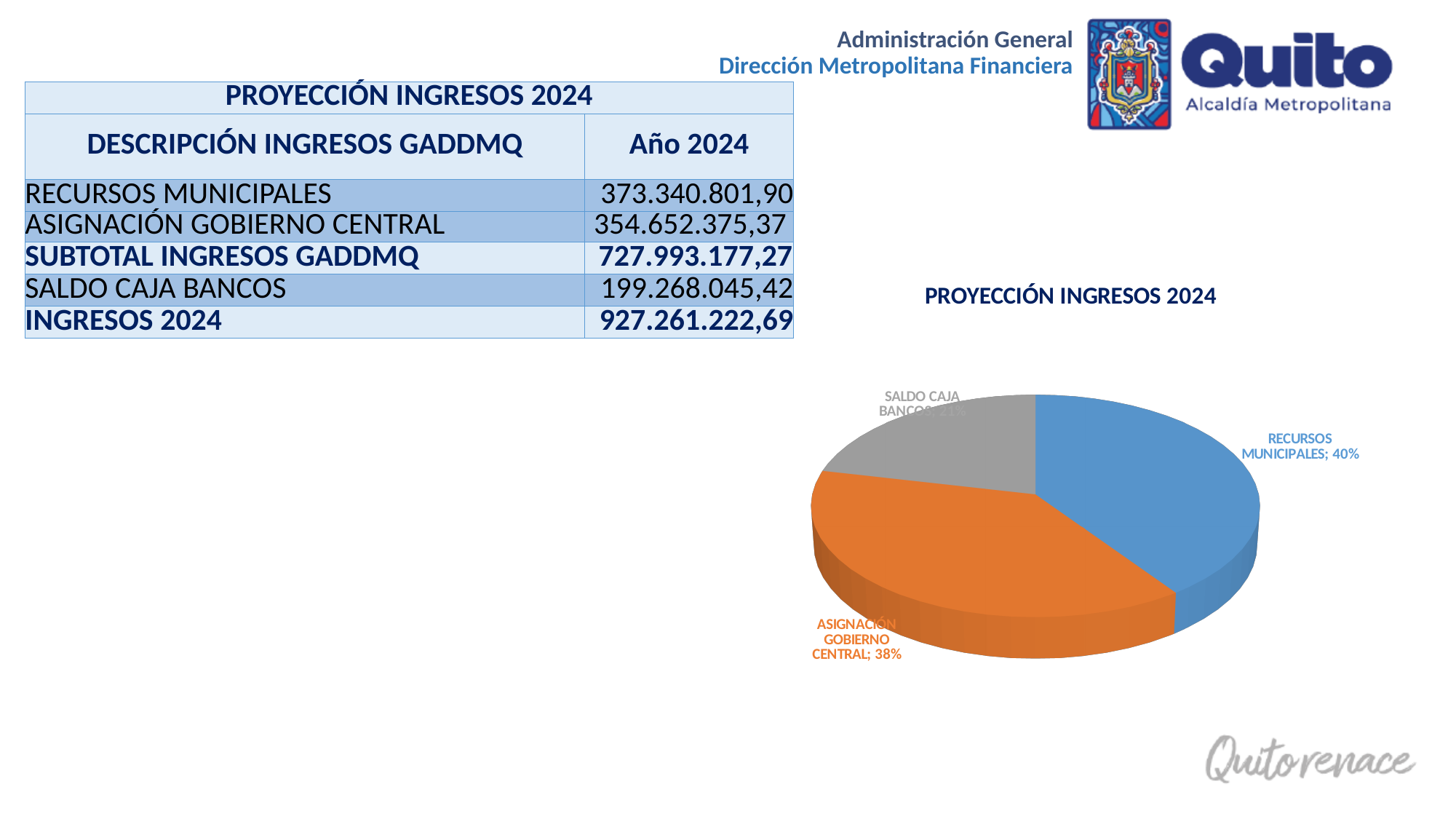
Which is larger in the pie chart, ASIGNACIÓN GOBIERNO CENTRAL or SALDO CAJA BANCOS? ASIGNACIÓN GOBIERNO CENTRAL By how many percentage points does ASIGNACIÓN GOBIERNO CENTRAL exceed SALDO CAJA BANCOS in the pie chart? 17 percentage points What is the title of the pie chart? PROYECCIÓN INGRESOS 2024 Which slice of the pie chart is the smallest? SALDO CAJA BANCOS What share of the pie does RECURSOS MUNICIPALES represent? 40% How many slices does the pie chart have? 3 What share of the pie does SALDO CAJA BANCOS represent? 21% What share of the pie does ASIGNACIÓN GOBIERNO CENTRAL represent? 38% Which slice of the pie chart is the largest? RECURSOS MUNICIPALES What colour is the RECURSOS MUNICIPALES slice in the pie chart? blue What kind of chart is shown on the slide? pie chart By how many percentage points does RECURSOS MUNICIPALES exceed ASIGNACIÓN GOBIERNO CENTRAL in the pie chart? 2 percentage points